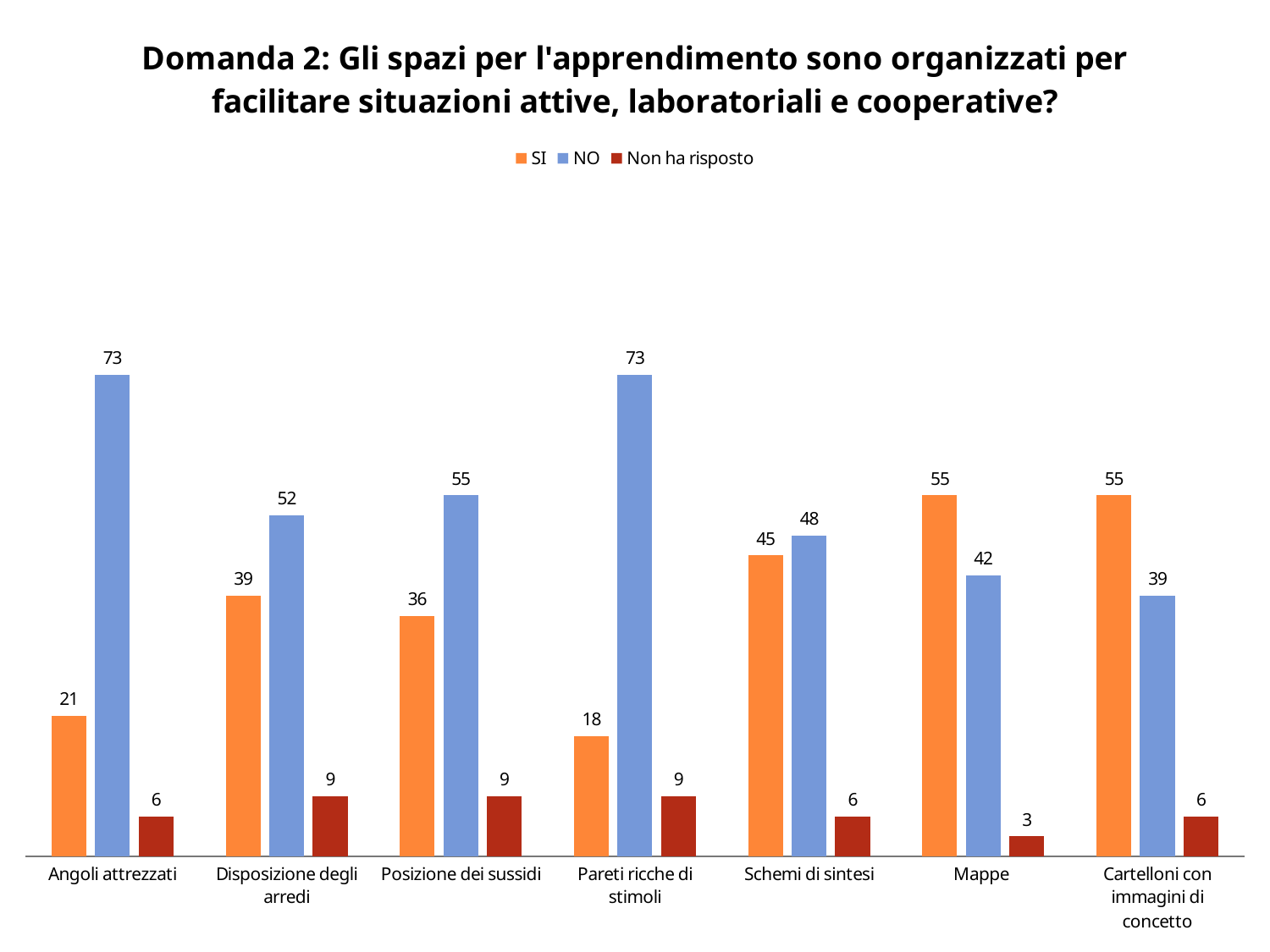
How many categories are shown on the x axis? 7 What is the total of the three values for Mappe? 100 Which series is shown in blue? NO What is the SI value for Angoli attrezzati? 21 What is the NO value for Pareti ricche di stimoli? 73 Which category has the lowest SI value? Pareti ricche di stimoli Which is larger for Schemi di sintesi, the SI value or the NO value? NO What kind of chart is shown on the slide? Bar chart What is the Non ha risposto value for Mappe? 3 How many series does the legend list? 3 Which category has the lowest NO value? Cartelloni con immagini di concetto What is the difference between the NO and SI values for Angoli attrezzati? 52